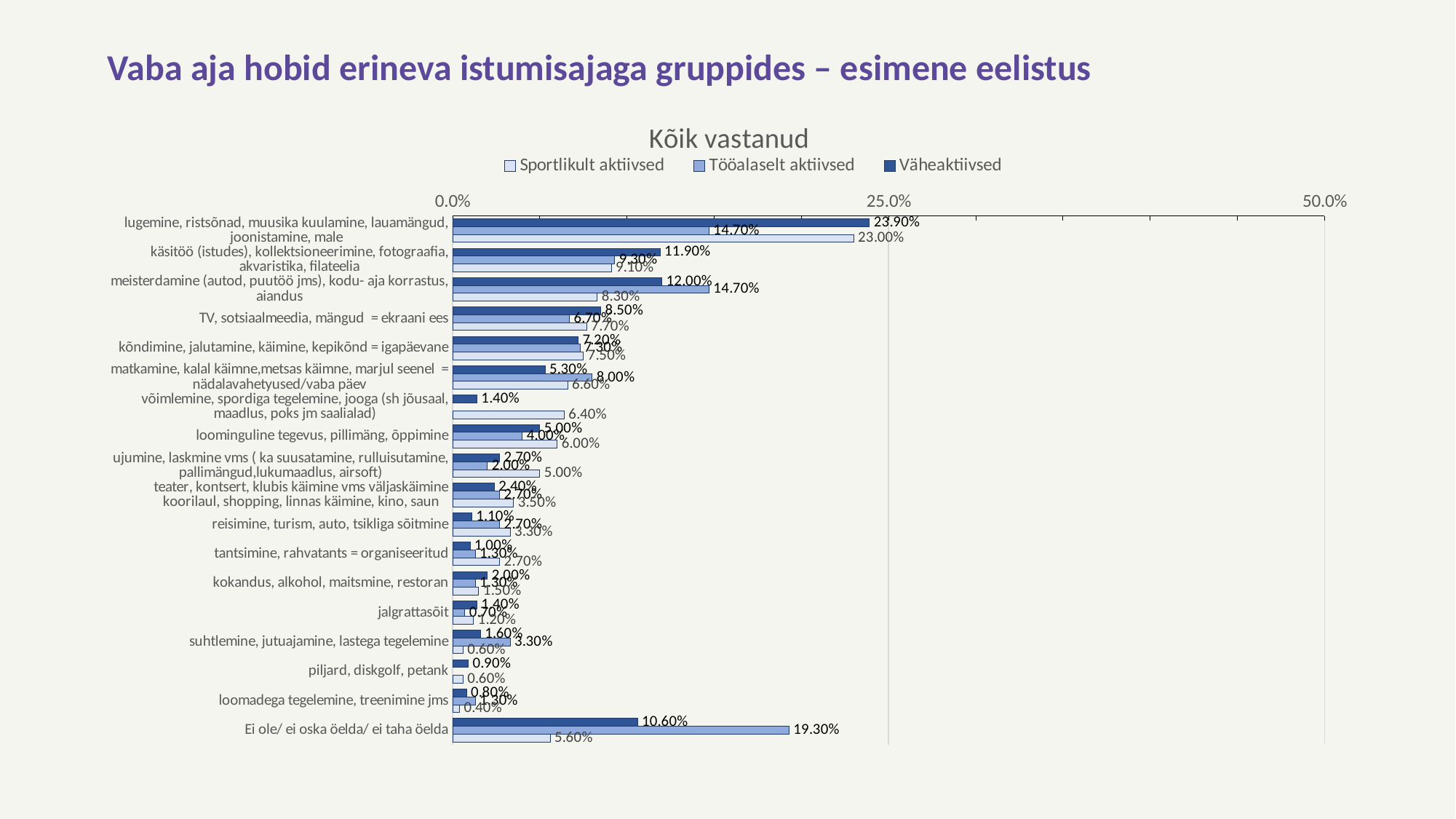
What is the difference between the Väheaktiivsed and Sportlikult aktiivsed values for 'Ei ole/ ei oska öelda/ ei taha öelda'? 5.00% How many series does the legend list? 3 What is the Tööalaselt aktiivsed value for 'Ei ole/ ei oska öelda/ ei taha öelda'? 19.30% Which category has the highest Sportlikult aktiivsed value? lugemine, ristsõnad, muusika kuulamine, lauamängud, joonistamine, male How many categories are plotted on the chart? 18 What is the Väheaktiivsed value for 'lugemine, ristsõnad, muusika kuulamine, lauamängud, joonistamine, male'? 23.90% Is the Väheaktiivsed value for 'lugemine, ristsõnad, muusika kuulamine, lauamängud, joonistamine, male' greater or less than 25.0%? less What is the title of the chart? Kõik vastanud What kind of chart is shown on the slide? bar chart Which category has the highest Tööalaselt aktiivsed value? Ei ole/ ei oska öelda/ ei taha öelda What is the Sportlikult aktiivsed value for 'meisterdamine (autod, puutöö jms), kodu- aja korrastus, aiandus'? 8.30% For 'suhtlemine, jutuajamine, lastega tegelemine', which is larger: the Tööalaselt aktiivsed value or the Sportlikult aktiivsed value? Tööalaselt aktiivsed